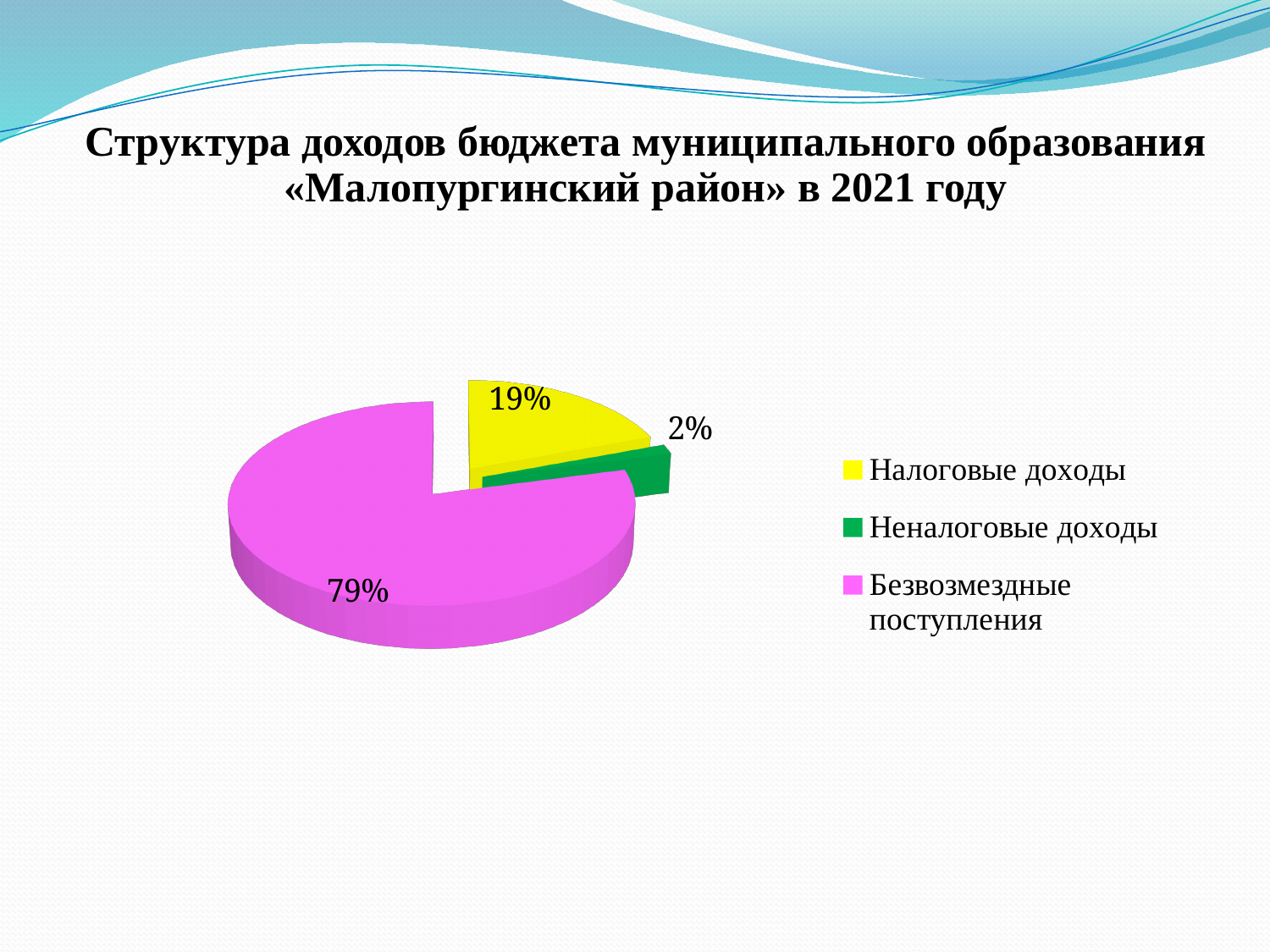
What colour is the slice for Безвозмездные поступления? Pink What share of the pie does Налоговые доходы represent? 19% How many categories does the pie chart show? 3 What kind of chart is shown on the slide? Pie chart What share of the pie does Неналоговые доходы represent? 2% Which category has the smallest share of the pie? Неналоговые доходы What is the title of the chart on the slide? Структура доходов бюджета муниципального образования «Малопургинский район» в 2021 году Which is larger, the share for Налоговые доходы or the share for Неналоговые доходы? Налоговые доходы Which category has the largest share of the pie? Безвозмездные поступления What is the difference in percentage points between Безвозмездные поступления and Налоговые доходы? 60 What share of the pie does Безвозмездные поступления represent? 79% What is the difference in percentage points between Налоговые доходы and Неналоговые доходы? 17